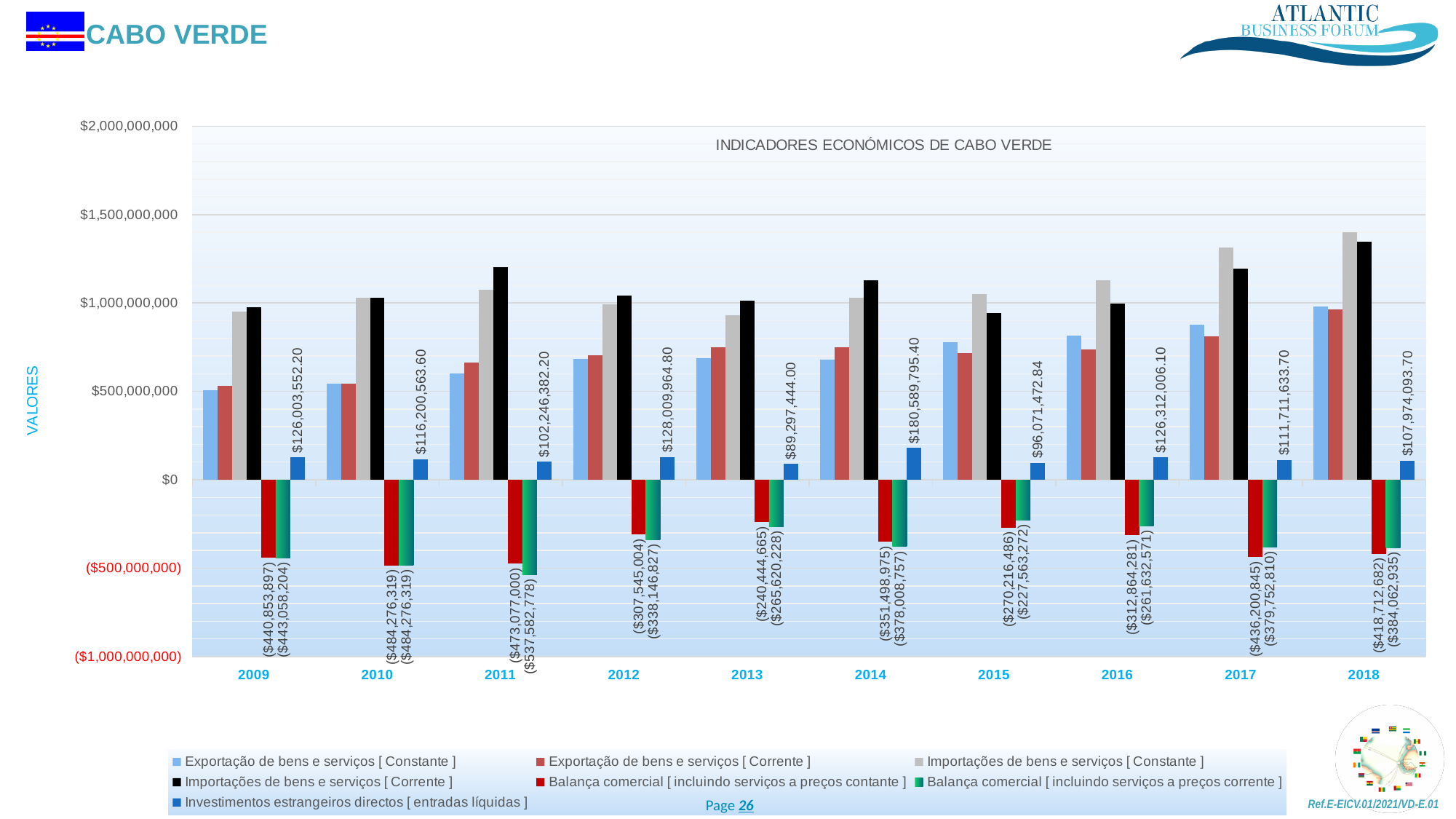
How many series does the chart legend list? 7 What kind of chart is shown on the slide? bar chart How many years are shown on the x axis of the chart? 10 What is the title of the chart? INDICADORES ECONÓMICOS DE CABO VERDE Is the value of Importações de bens e serviços [ Corrente ] for 2018 greater or less than $1,000,000,000? greater What is the difference between Investimentos estrangeiros directos in 2014 and in 2013? $91,292,351.40 In which year is Investimentos estrangeiros directos [ entradas líquidas ] lowest? 2013 What is the value of Balança comercial [ incluindo serviços a preços corrente ] for 2011? ($537,582,778) In which year is Investimentos estrangeiros directos [ entradas líquidas ] highest? 2014 Which year has the larger value for Investimentos estrangeiros directos [ entradas líquidas ], 2009 or 2010? 2009 Does Exportação de bens e serviços [ Constante ] rise or fall from 2015 to 2018? rise What is the value of Investimentos estrangeiros directos [ entradas líquidas ] for 2014? $180,589,795.40